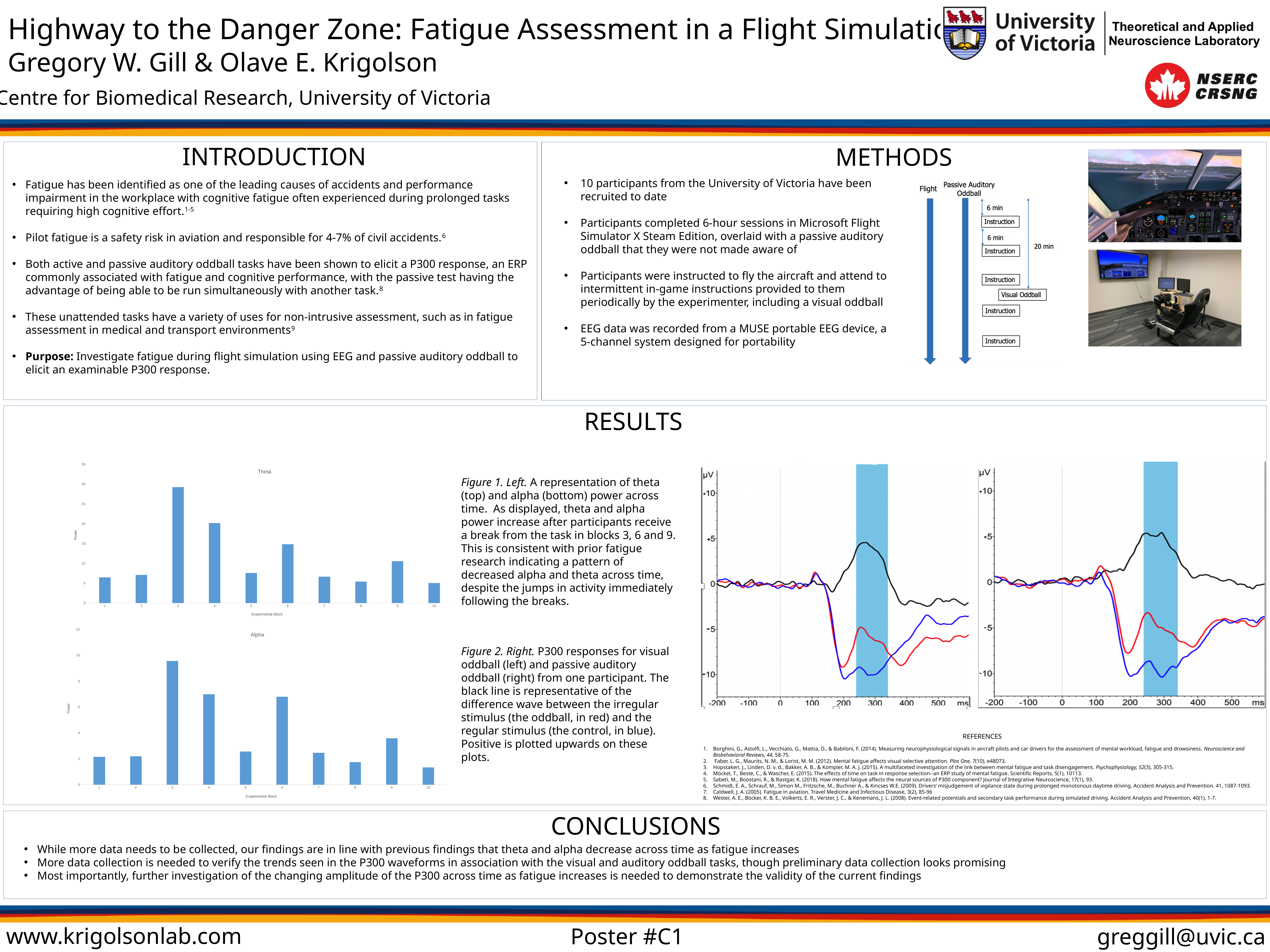
In the Alpha chart, which experimental block has the highest power? 3 In the Alpha chart, is the value for experimental block 4 greater or less than 6? greater In the Theta chart, which experimental block has the highest power? 3 In the Theta chart, is the value for experimental block 6 greater or less than 10? greater What is the label on the x axis of the Theta chart? Experimental Block What is the label on the y axis of the Alpha chart? Power What kind of chart is the Theta chart on the left of the Results section? bar chart In the Theta chart, is the value for experimental block 3 greater or less than 25? greater In the Theta chart, which has the higher power, experimental block 3 or experimental block 4? 3 In the Alpha chart, which has the higher power, experimental block 6 or experimental block 9? 6 In the Theta chart, how many experimental blocks are plotted? 10